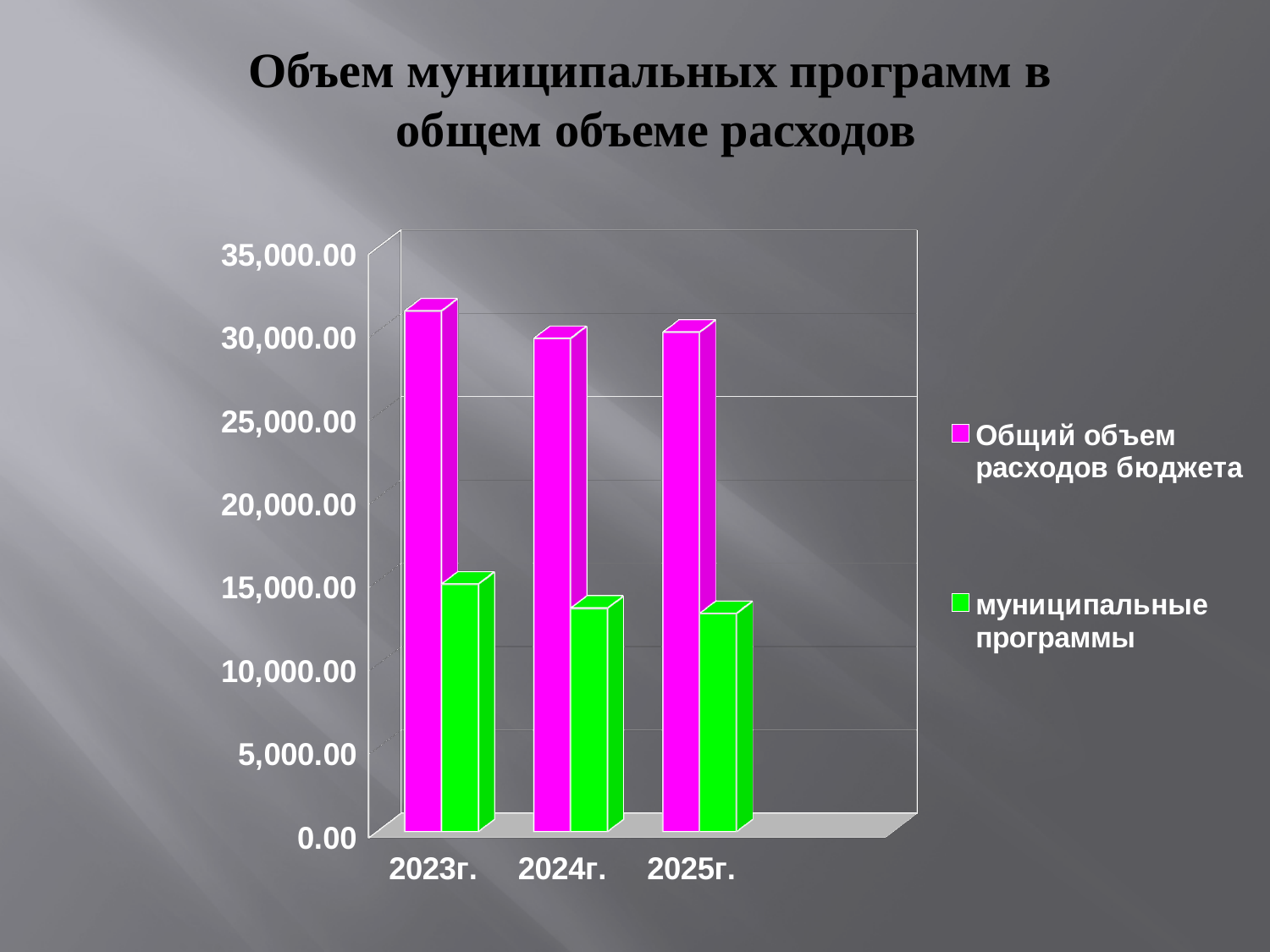
In 2025г., which is larger: Общий объем расходов бюджета or муниципальные программы? Общий объем расходов бюджета Which year has the highest value for муниципальные программы? 2023г. How many year categories are shown on the x axis? 3 What colour represents муниципальные программы in the legend? green What is the title of the chart? Объем муниципальных программ в общем объеме расходов What kind of chart is shown on the slide? bar chart Is the value for муниципальные программы in 2024г. greater or less than 15,000.00? less Is the value for муниципальные программы in 2025г. greater or less than 10,000.00? greater How many series does the legend list? 2 Do the values for муниципальные программы rise or fall from 2023г. to 2025г.? fall Which year has the highest value for Общий объем расходов бюджета? 2023г. Is the value for Общий объем расходов бюджета in 2023г. greater or less than 30,000.00? greater